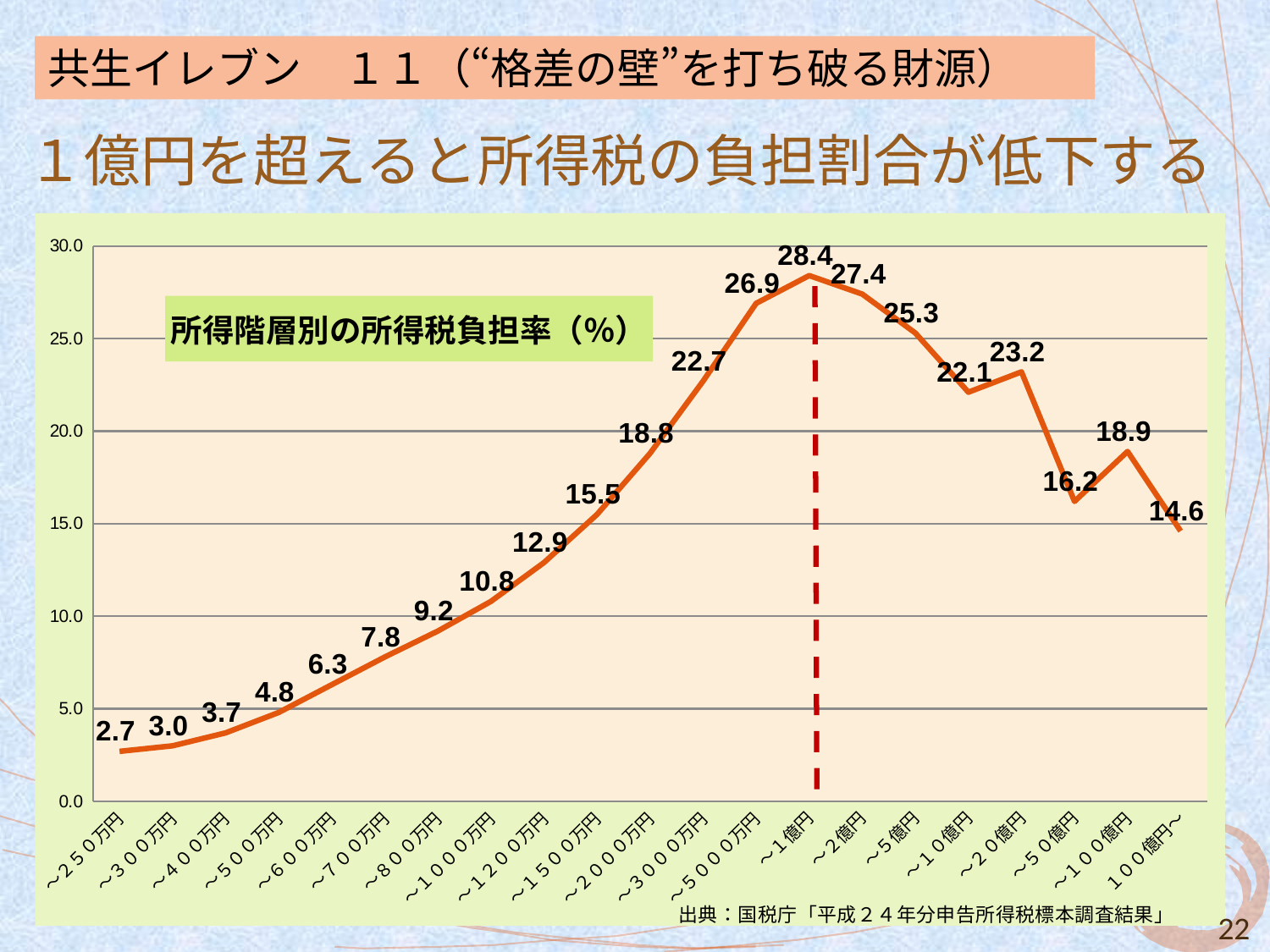
What is the income tax burden rate for the ～1億円 bracket? 28.4 What is the value plotted for the ～50億円 bracket? 16.2 Which bracket has a higher value, ～10億円 or ～20億円? ～20億円 What is the income tax burden rate for the ～250万円 bracket? 2.7 What is the difference between the values for ～1億円 and 100億円～? 13.8 What is the title shown in the box inside the chart? 所得階層別の所得税負担率（%） Does the line rise or fall from ～1億円 to ～10億円? fall What type of chart is shown on the slide? line chart Which income bracket has the highest income tax burden rate? ～1億円 How many income brackets are plotted on the x axis? 21 What is the value plotted for the 100億円～ bracket? 14.6 Which income bracket has the lowest income tax burden rate? ～250万円